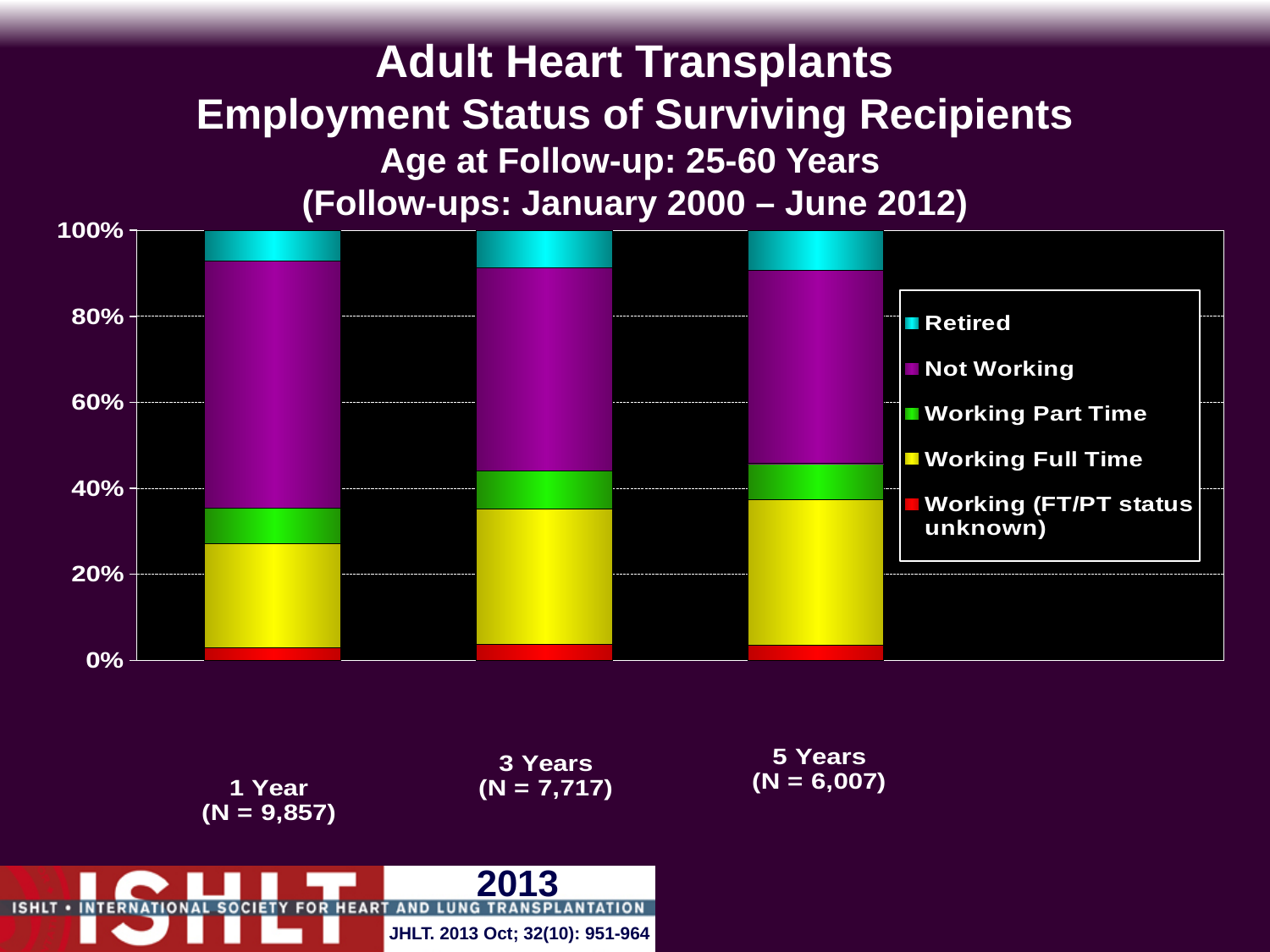
Does the Not Working share rise or fall from 1 Year to 5 Years? Fall Is the Working Full Time share for 5 Years greater or less than 20%? greater Which has the larger Working Full Time share, 1 Year or 5 Years? 5 Years How many follow-up time categories are plotted on the x axis? 3 Is the Retired share for 1 Year greater or less than 20%? less Which series is shown at the bottom of each stacked bar? Working (FT/PT status unknown) What is the sample size (N) shown for the 3 Years category? N = 7,717 Which has the larger Not Working share, 1 Year or 5 Years? 1 Year What kind of chart is shown on the slide? Stacked bar chart Is the Working Part Time share for 3 Years greater or less than 20%? less How many series does the legend list? 5